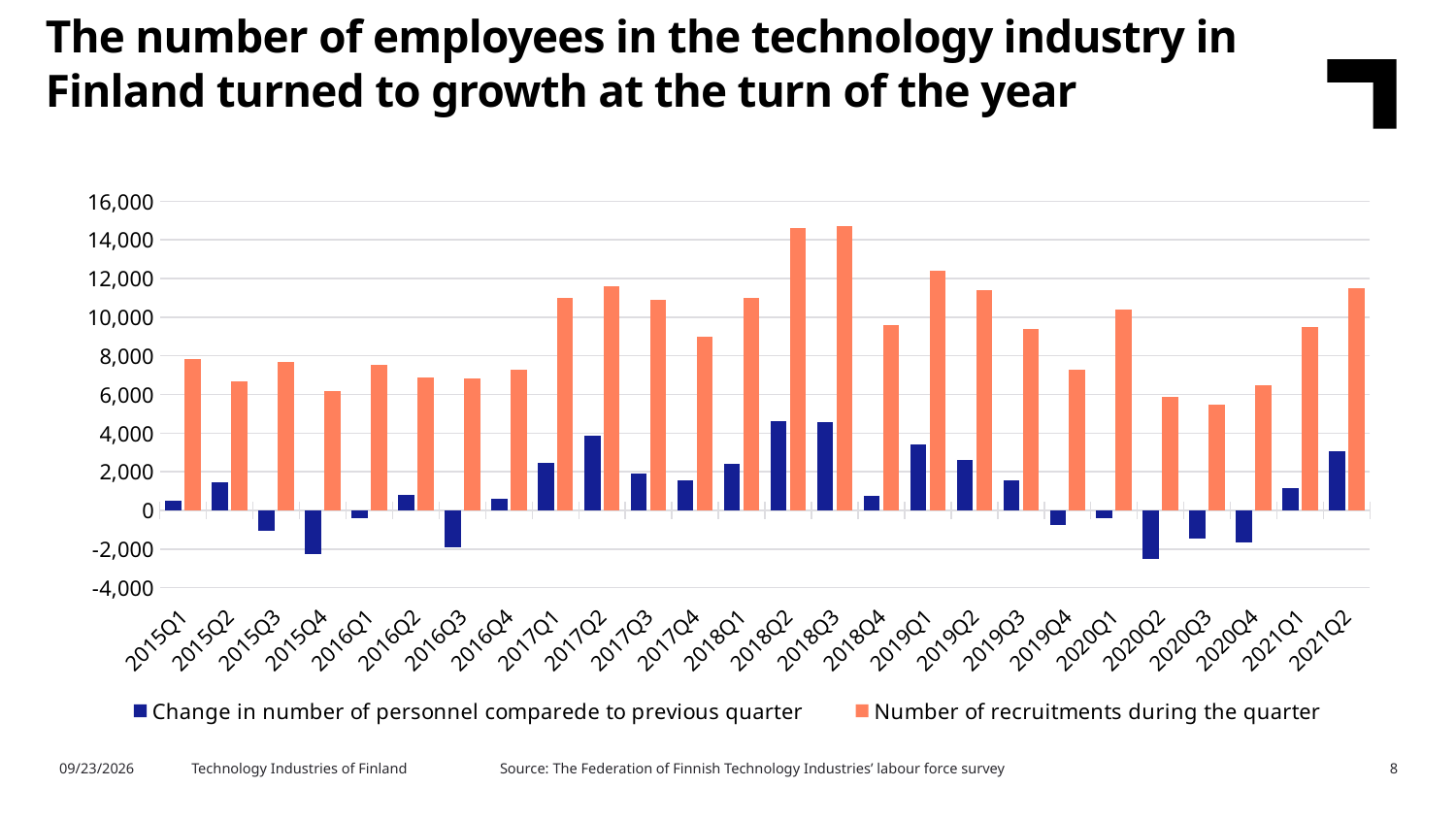
Is the number of recruitments during the quarter for 2015Q1 greater or less than 6,000? greater Which quarter has a larger change in number of personnel compared to previous quarter, 2021Q1 or 2021Q2? 2021Q2 Which quarter has more recruitments during the quarter, 2019Q1 or 2019Q2? 2019Q1 Is the number of recruitments during the quarter for 2018Q2 greater or less than 14,000? greater How many quarters are shown on the x axis? 26 Do the number of recruitments during the quarter rise or fall from 2020Q3 to 2021Q2? rise Is the number of recruitments during the quarter for 2020Q3 greater or less than 6,000? less How many series does the legend list? 2 What kind of chart is shown on the slide? bar chart Which quarter has the lowest change in number of personnel compared to previous quarter? 2020Q2